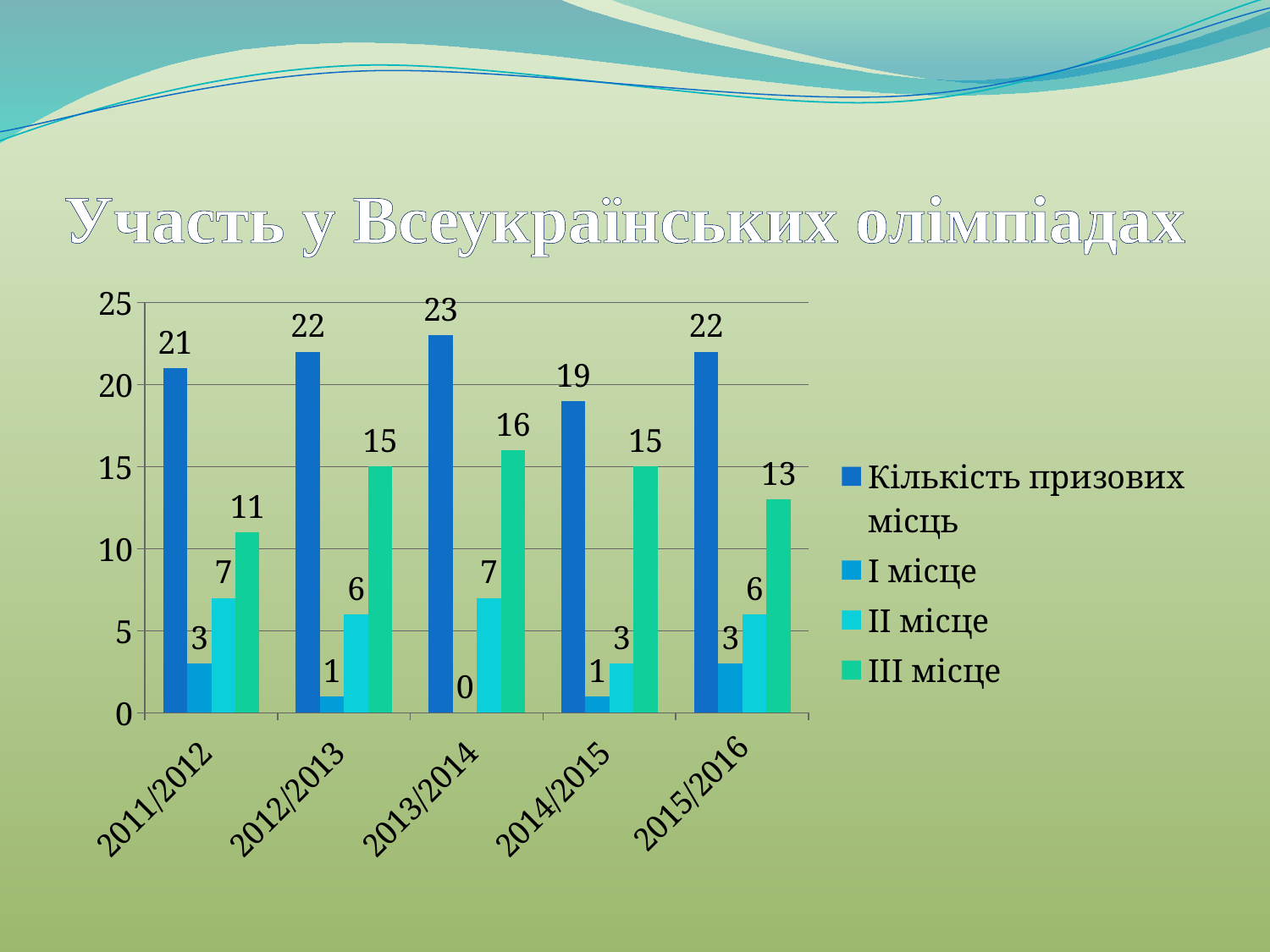
What is the value of 'I місце' for 2013/2014? 0 What is the title of the chart on the slide? Участь у Всеукраїнських олімпіадах What is the difference between 'III місце' in 2013/2014 and 'III місце' in 2011/2012? 5 In which year is 'Кількість призових місць' the lowest? 2014/2015 How many school years (categories) are shown on the x axis? 5 Does 'Кількість призових місць' rise or fall from 2013/2014 to 2014/2015? fall How many series does the legend list? 4 What is the value of 'III місце' for 2015/2016? 13 Which is larger: 'II місце' in 2011/2012 or 'II місце' in 2014/2015? 2011/2012 What is the value of 'Кількість призових місць' for 2013/2014? 23 In which year is 'Кількість призових місць' the highest? 2013/2014 What type of chart is shown on the slide? bar chart